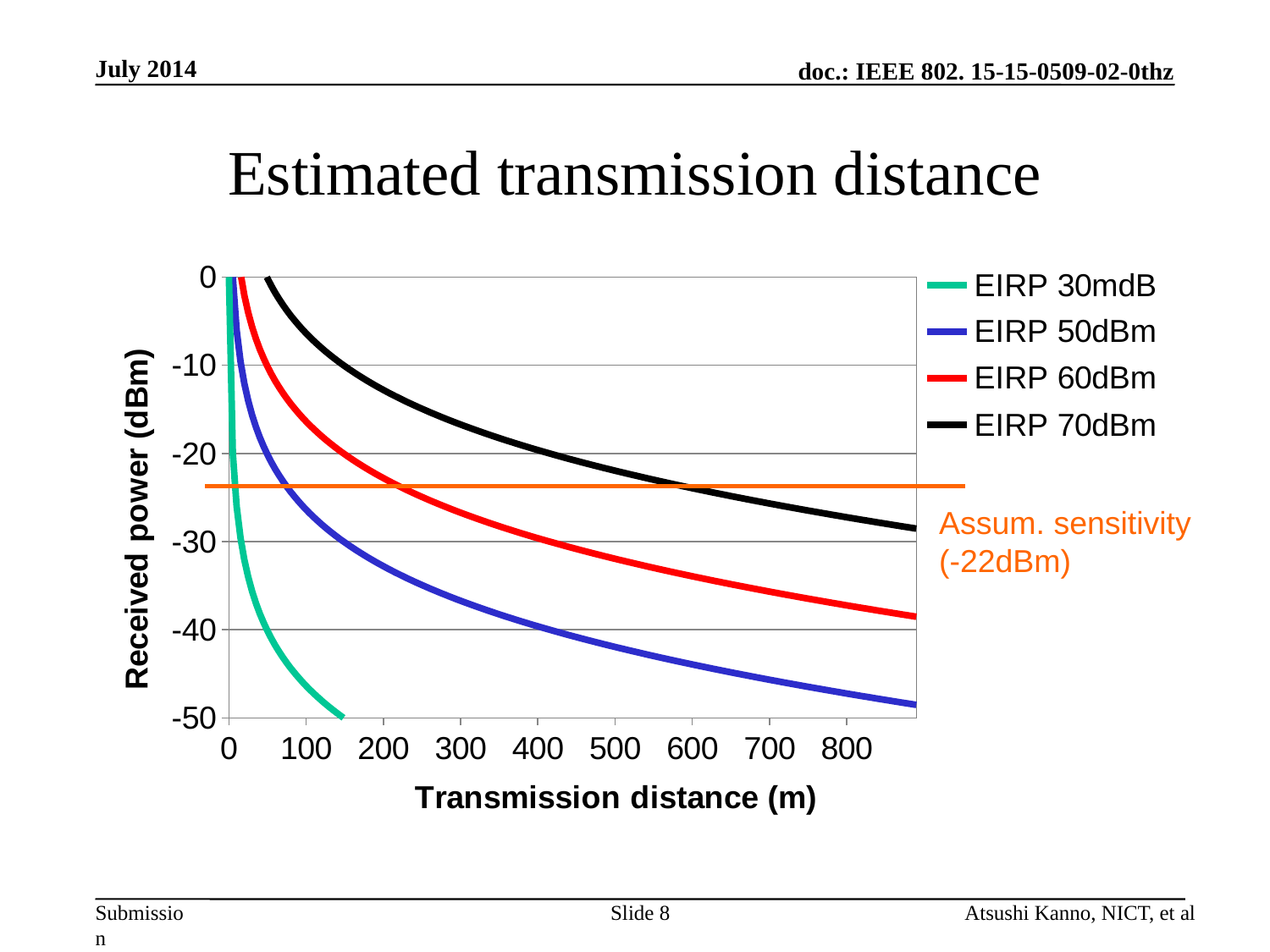
What kind of chart is shown on the slide? Line chart Does the received power for EIRP 70dBm rise or fall as transmission distance increases? Fall What is the assumed sensitivity indicated by the orange horizontal line? -22dBm How many series does the legend list? 4 Is the received power for EIRP 30mdB at 100 m greater or less than -40 dBm? less What is the title of the chart? Estimated transmission distance Is the received power for EIRP 50dBm at 800 m greater or less than -40 dBm? less At a transmission distance of 400 m, which series has the larger received power, EIRP 70dBm or EIRP 50dBm? EIRP 70dBm Is the received power for EIRP 70dBm at 800 m greater or less than -30 dBm? greater Which series has the highest received power at a transmission distance of 800 m? EIRP 70dBm Which series has the lowest received power at a transmission distance of 100 m? EIRP 30mdB